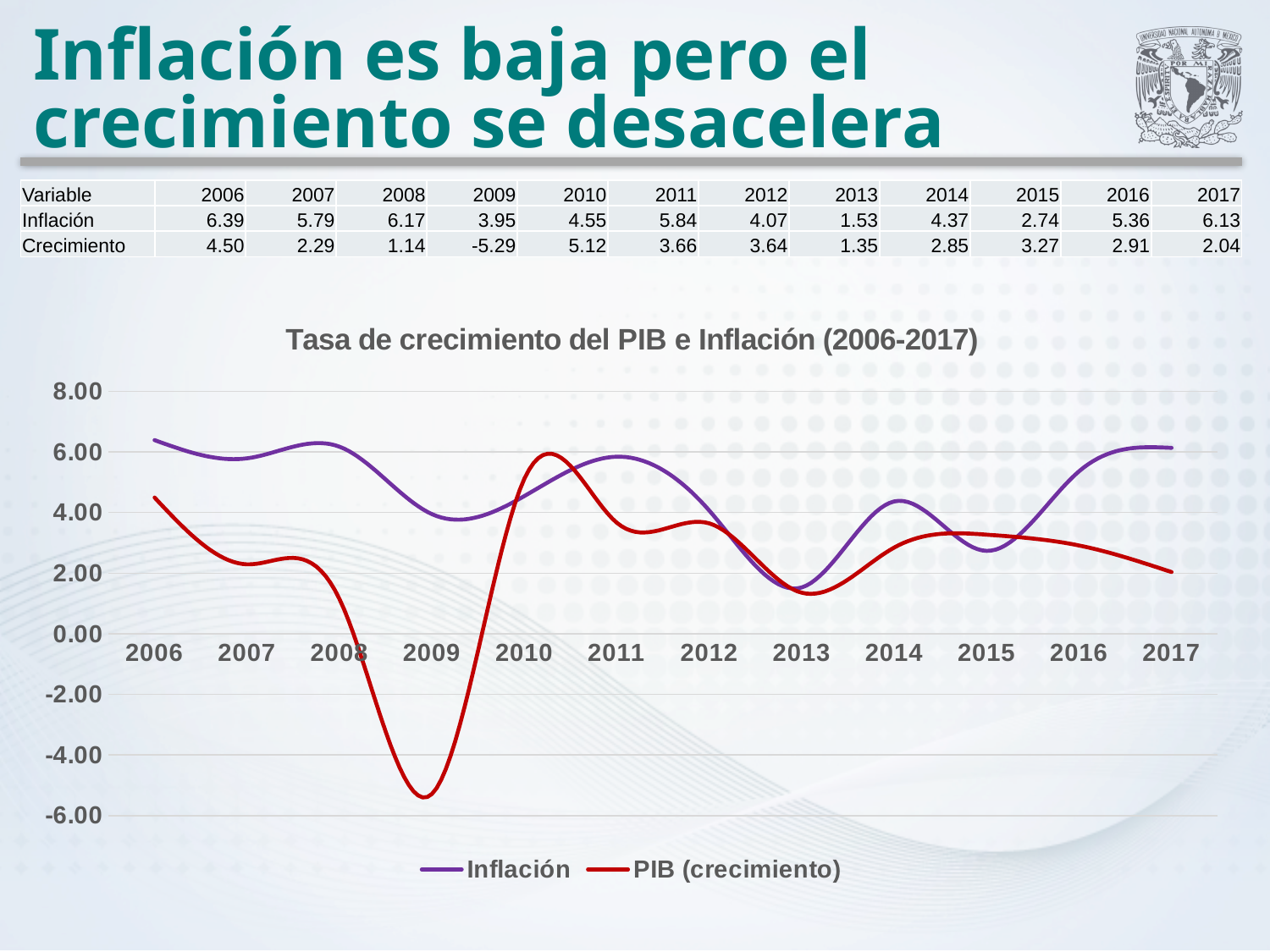
How many series does the chart legend list? 2 Which is larger in 2010, Inflación or PIB (crecimiento)? PIB (crecimiento) What is the Inflación value for 2013? 1.53 What type of chart is shown on the slide? line chart What is the difference between Inflación and PIB (crecimiento) in 2017? 4.09 In which year is Inflación highest? 2006 In which year is PIB (crecimiento) lowest? 2009 What is the title of the chart? Tasa de crecimiento del PIB e Inflación (2006-2017) How many years are plotted along the x axis of the chart? 12 Is the PIB (crecimiento) value for 2009 greater or less than -4.00? less What is the PIB (crecimiento) value for 2009? -5.29 Does PIB (crecimiento) rise or fall from 2015 to 2017? fall